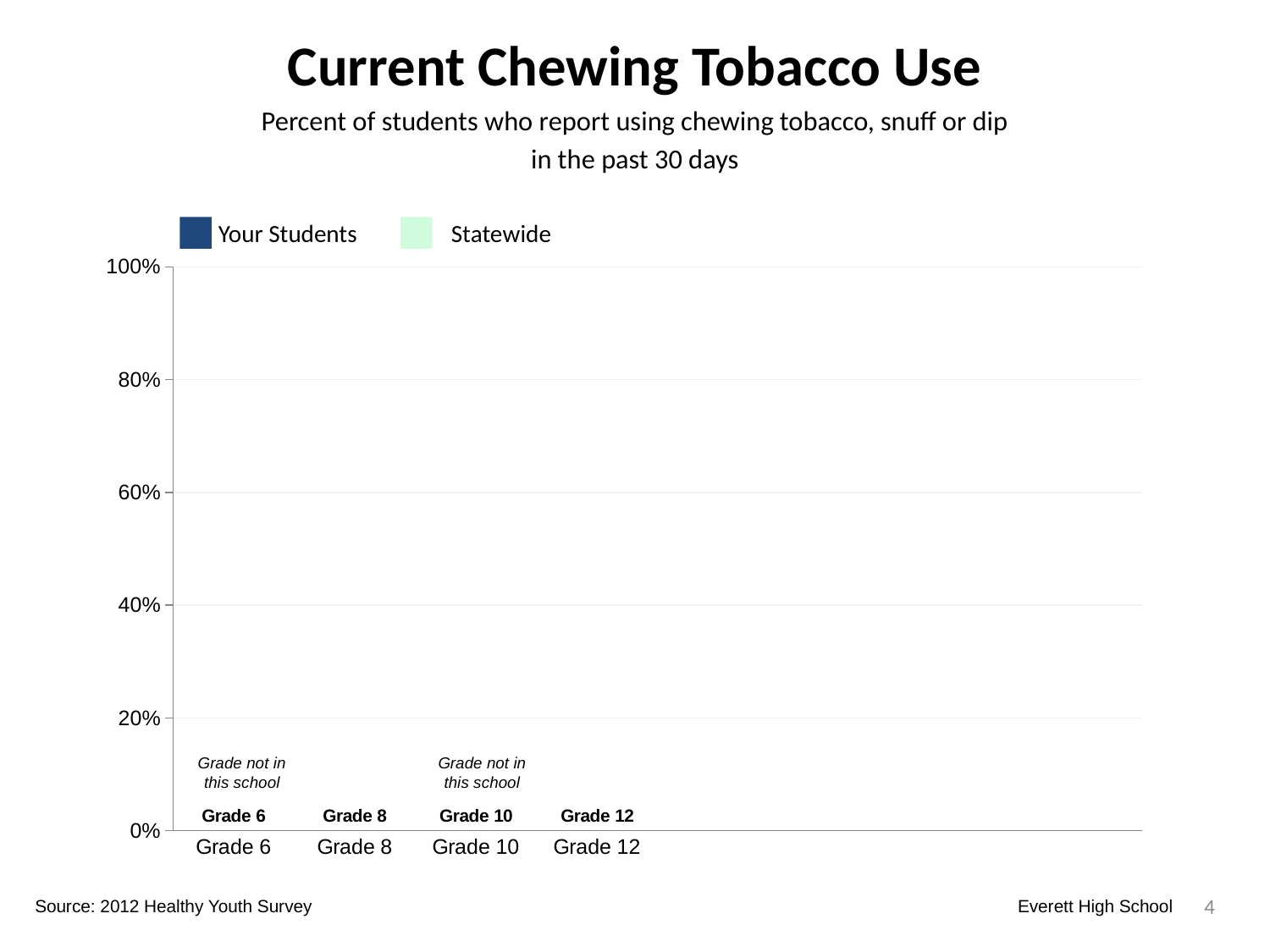
How many grade categories are shown on the x axis of the chart? 4 What is the source cited for the chart's data? 2012 Healthy Youth Survey What are the two series named in the chart legend? Your Students and Statewide Which grades on the chart are marked as 'Grade not in this school'? Grade 6 and Grade 10 What is the title of the chart? Current Chewing Tobacco Use How many series does the chart legend list? 2 What is the highest value shown on the chart's y axis? 100%